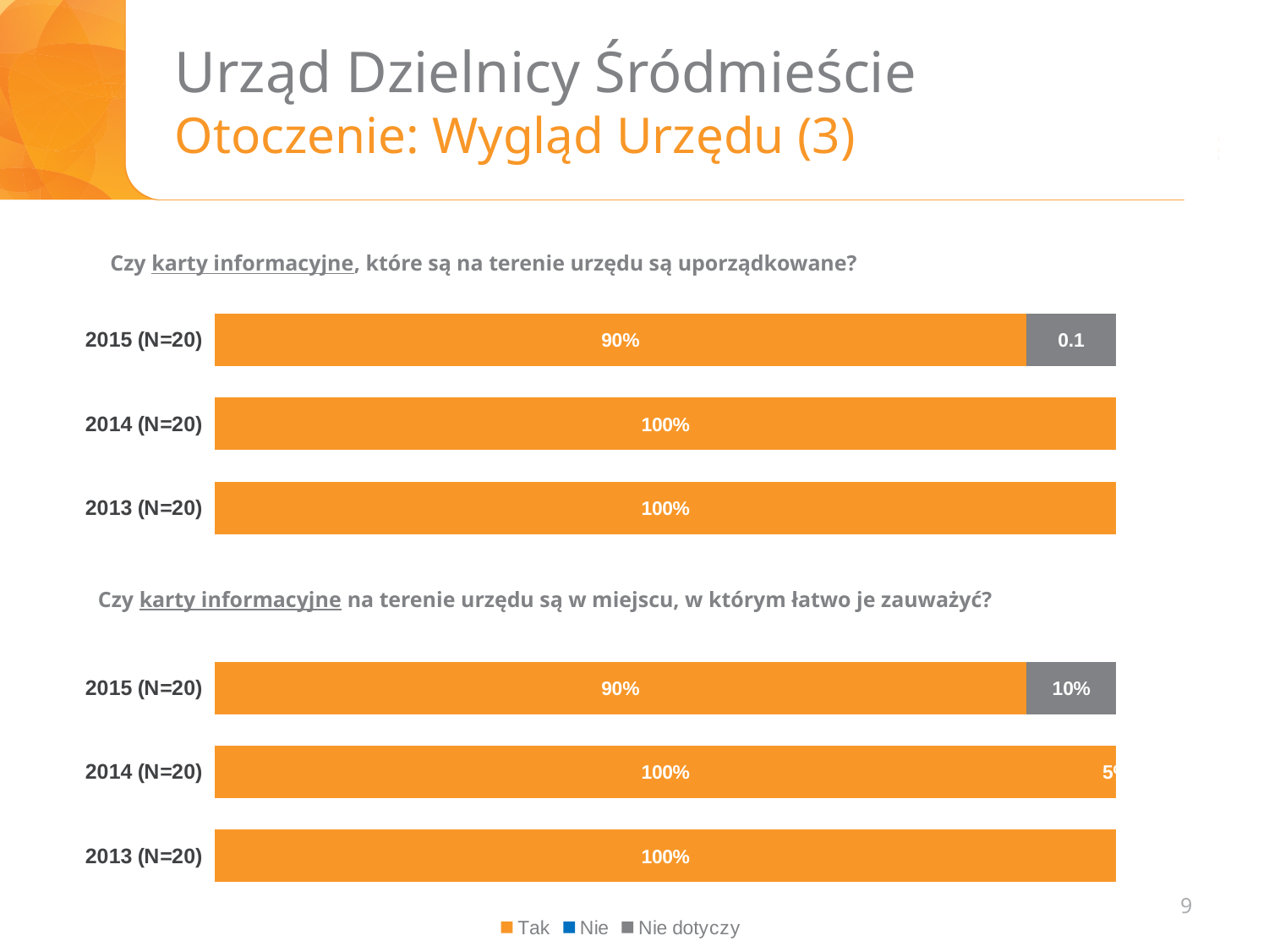
In the top chart, what is the value of the "Tak" segment for 2014 (N=20)? 100% In the bottom chart, what is the value of the "Tak" segment for 2013 (N=20)? 100% In the bottom chart, what is the value of the grey segment for 2015 (N=20)? 10% In the top chart, which year has the lowest "Tak" value? 2015 (N=20) In the bottom chart ("Czy karty informacyjne na terenie urzędu są w miejscu, w którym łatwo je zauważyć?"), what is the value of the "Tak" segment for 2015 (N=20)? 90% In the top chart ("Czy karty informacyjne, które są na terenie urzędu są uporządkowane?"), what is the value of the orange "Tak" segment for 2015 (N=20)? 90% How many year categories does the top chart show? 3 According to the legend, which series is shown in orange? Tak How many series does the legend at the bottom of the slide list? 3 What type of chart is used on this slide? Bar chart In the bottom chart, what is the difference between the "Tak" value for 2013 (N=20) and the "Tak" value for 2015 (N=20)? 10 percentage points In the top chart, what label is printed on the grey segment for 2015 (N=20)? 0.1